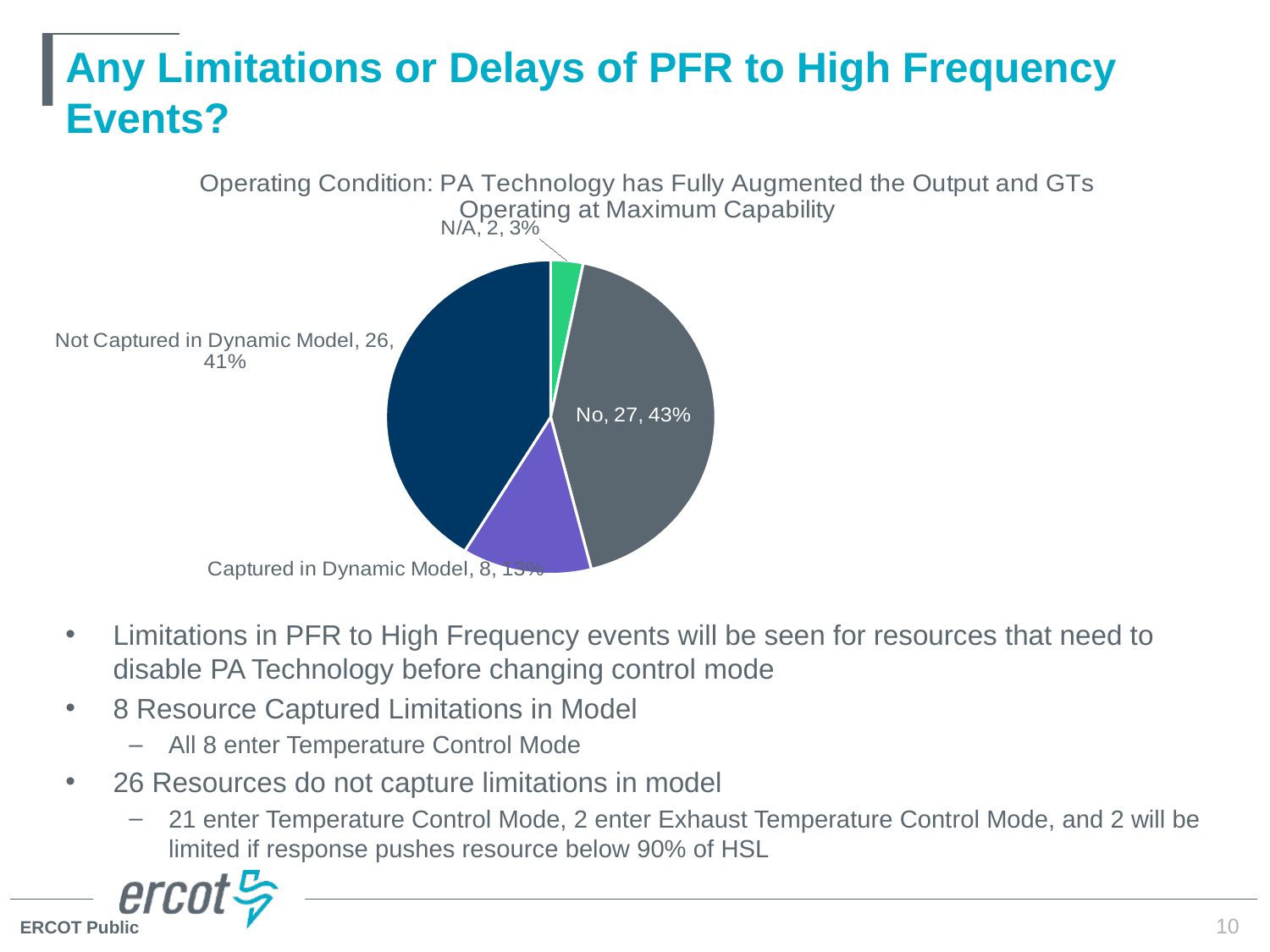
What is the count for the "Captured in Dynamic Model" slice? 8 What percentage share does the "No" slice represent? 43% What is the count for the "No" slice of the pie chart? 27 Which slice of the pie chart is the largest? No What is the difference in count between the "No" slice and the "Captured in Dynamic Model" slice? 19 Which is larger, the "Not Captured in Dynamic Model" slice or the "Captured in Dynamic Model" slice? Not Captured in Dynamic Model What is the count for the "Not Captured in Dynamic Model" slice? 26 What percentage share does the "Not Captured in Dynamic Model" slice represent? 41% How many slices does the pie chart have? 4 What kind of chart is shown on the slide? pie chart What percentage share does the "N/A" slice represent? 3% Which slice of the pie chart is the smallest? N/A